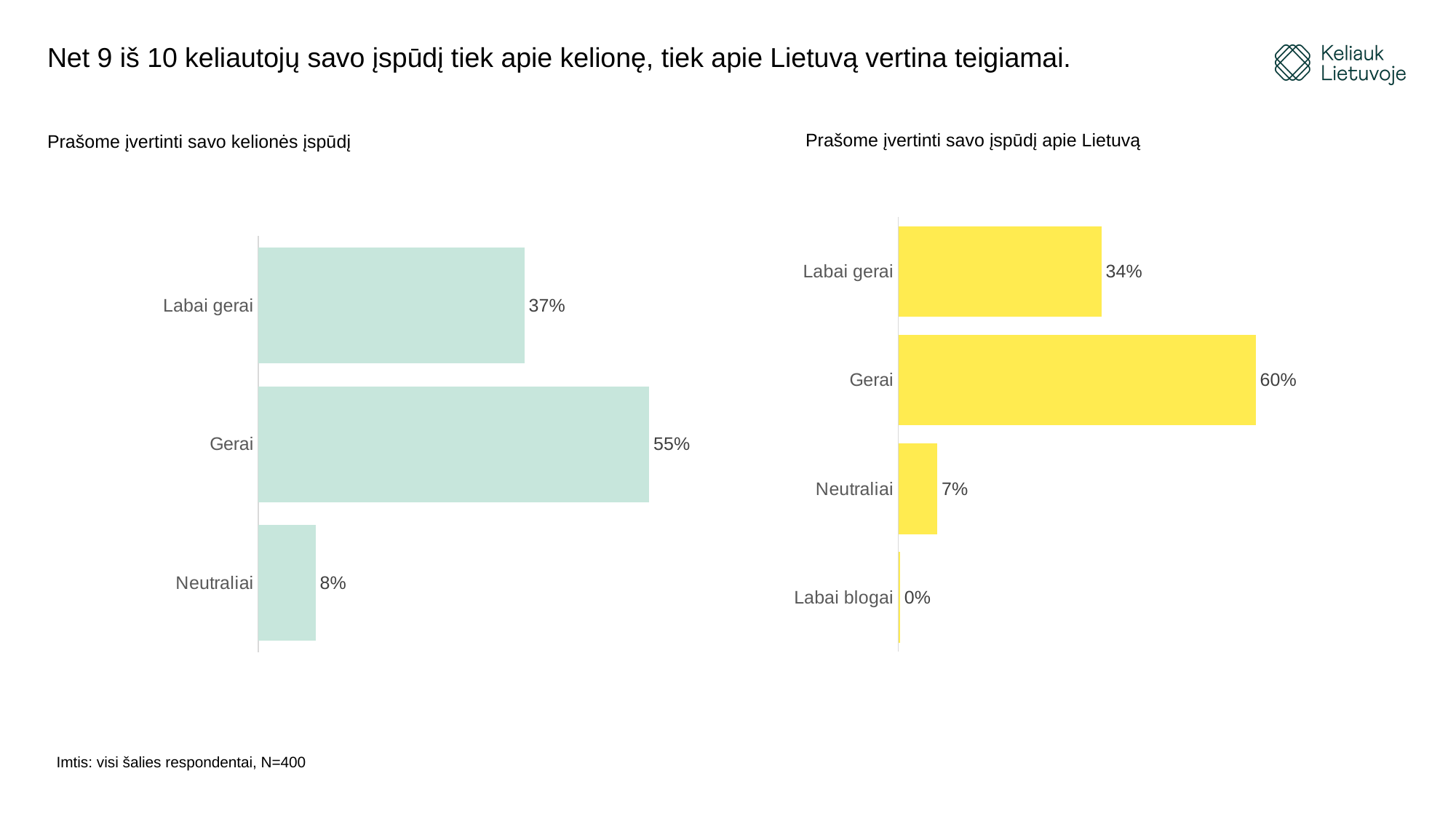
In the left chart 'Prašome įvertinti savo kelionės įspūdį', what is the difference between Gerai and Labai gerai? 18% In the right chart 'Prašome įvertinti savo įspūdį apie Lietuvą', which category has the lowest value? Labai blogai In the right chart 'Prašome įvertinti savo įspūdį apie Lietuvą', which is larger, Labai gerai or Neutraliai? Labai gerai In the right chart 'Prašome įvertinti savo įspūdį apie Lietuvą', what is the value for Labai blogai? 0% In the right chart 'Prašome įvertinti savo įspūdį apie Lietuvą', what is the value for Labai gerai? 34% In the left chart 'Prašome įvertinti savo kelionės įspūdį', what is the value for Gerai? 55% What kind of chart is the left chart 'Prašome įvertinti savo kelionės įspūdį'? Bar chart How many categories does the right chart 'Prašome įvertinti savo įspūdį apie Lietuvą' show? 4 In the left chart 'Prašome įvertinti savo kelionės įspūdį', what is the value for Neutraliai? 8% How many categories does the left chart 'Prašome įvertinti savo kelionės įspūdį' show? 3 In the right chart 'Prašome įvertinti savo įspūdį apie Lietuvą', what is the difference between Gerai and Neutraliai? 53% In the left chart 'Prašome įvertinti savo kelionės įspūdį', which category has the highest value? Gerai